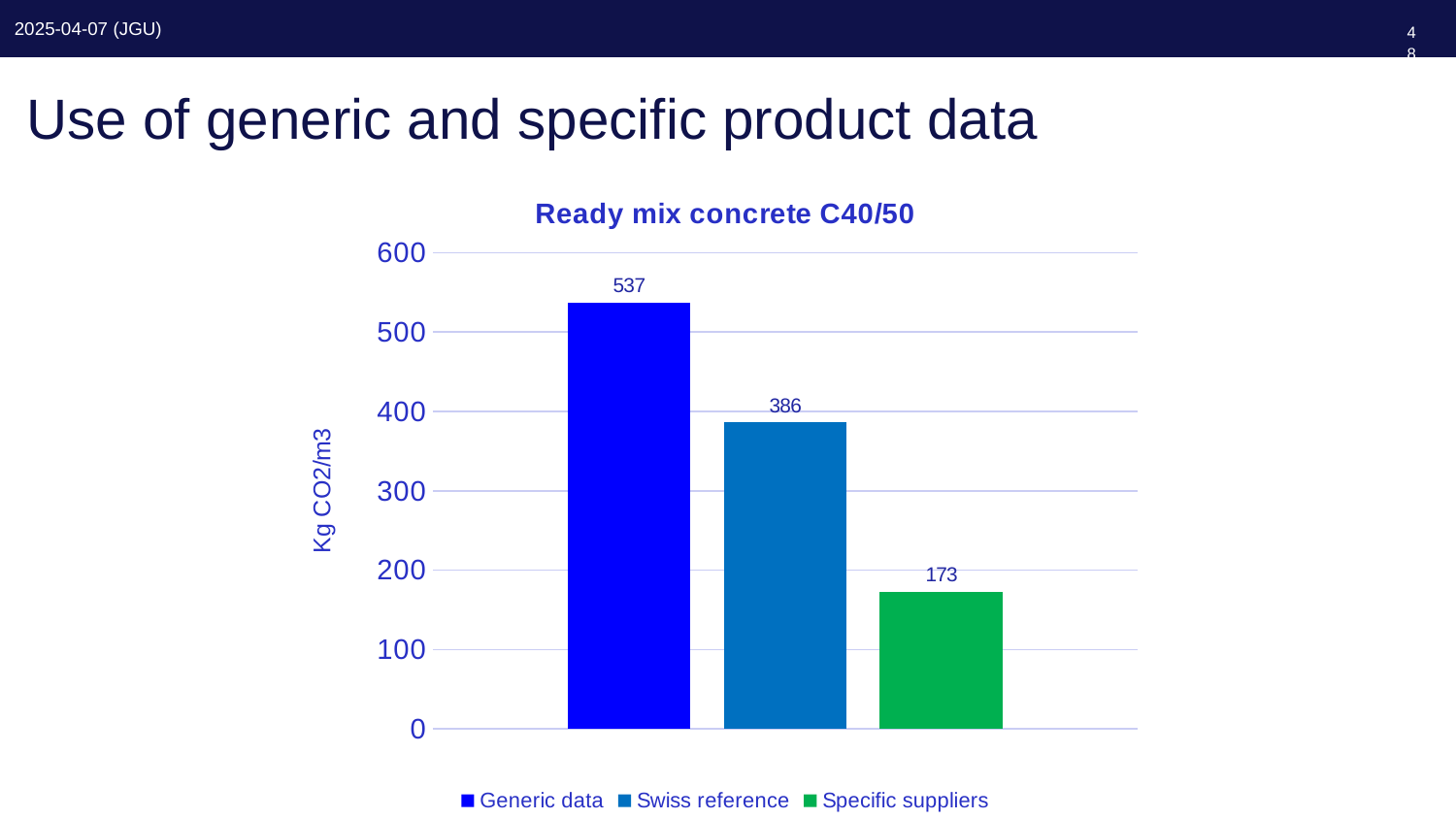
What is the title of the chart? Ready mix concrete C40/50 What is the value for Generic data? 537 Is the value for Swiss reference greater or less than 400? less What is the value for Swiss reference? 386 Which is larger, the value for Swiss reference or the value for Specific suppliers? Swiss reference How many series does the legend list? 3 What is the difference between the Generic data value and the Swiss reference value? 151 Which series has the highest value? Generic data Which series has the lowest value? Specific suppliers What is the value for Specific suppliers? 173 What is the difference between the Generic data value and the Specific suppliers value? 364 What kind of chart is shown? bar chart